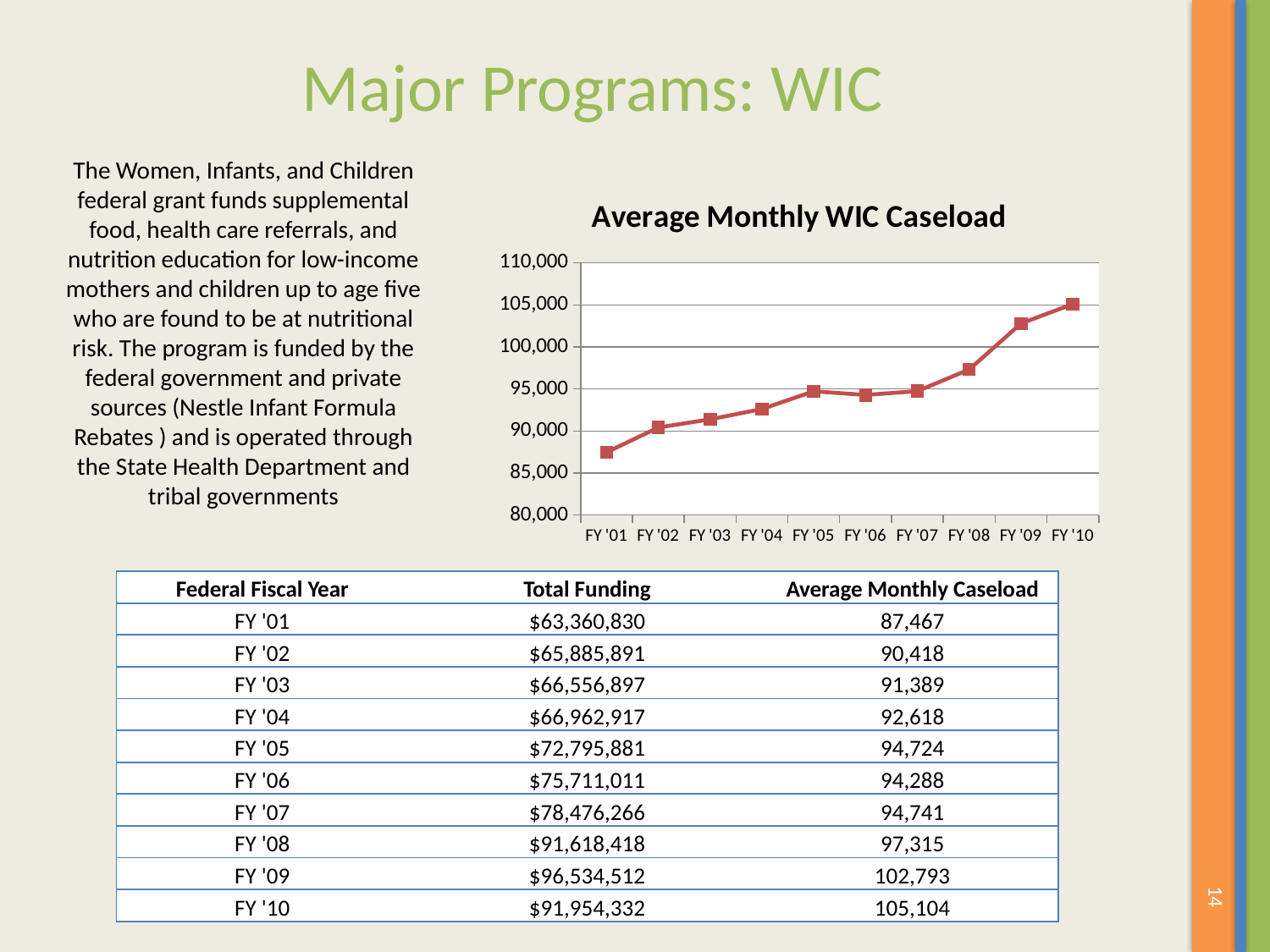
Which is larger, the average monthly WIC caseload in FY '05 or in FY '03? FY '05 What is the title of the chart on the slide? Average Monthly WIC Caseload What is the difference between the average monthly WIC caseload in FY '10 and FY '01, using the values shown on the slide? 17,637 Does the average monthly WIC caseload generally rise or fall from FY '01 to FY '10? rise What is the average monthly WIC caseload for FY '10 as shown on the slide? 105,104 Is the average monthly WIC caseload for FY '09 greater or less than 100,000? greater What type of chart is the Average Monthly WIC Caseload chart? line chart Which fiscal year has the lowest average monthly WIC caseload? FY '01 Is the average monthly WIC caseload for FY '08 greater or less than 95,000? greater Which fiscal year has the highest average monthly WIC caseload? FY '10 How many fiscal years are plotted on the Average Monthly WIC Caseload chart? 10 Is the average monthly WIC caseload for FY '01 greater or less than 90,000? less